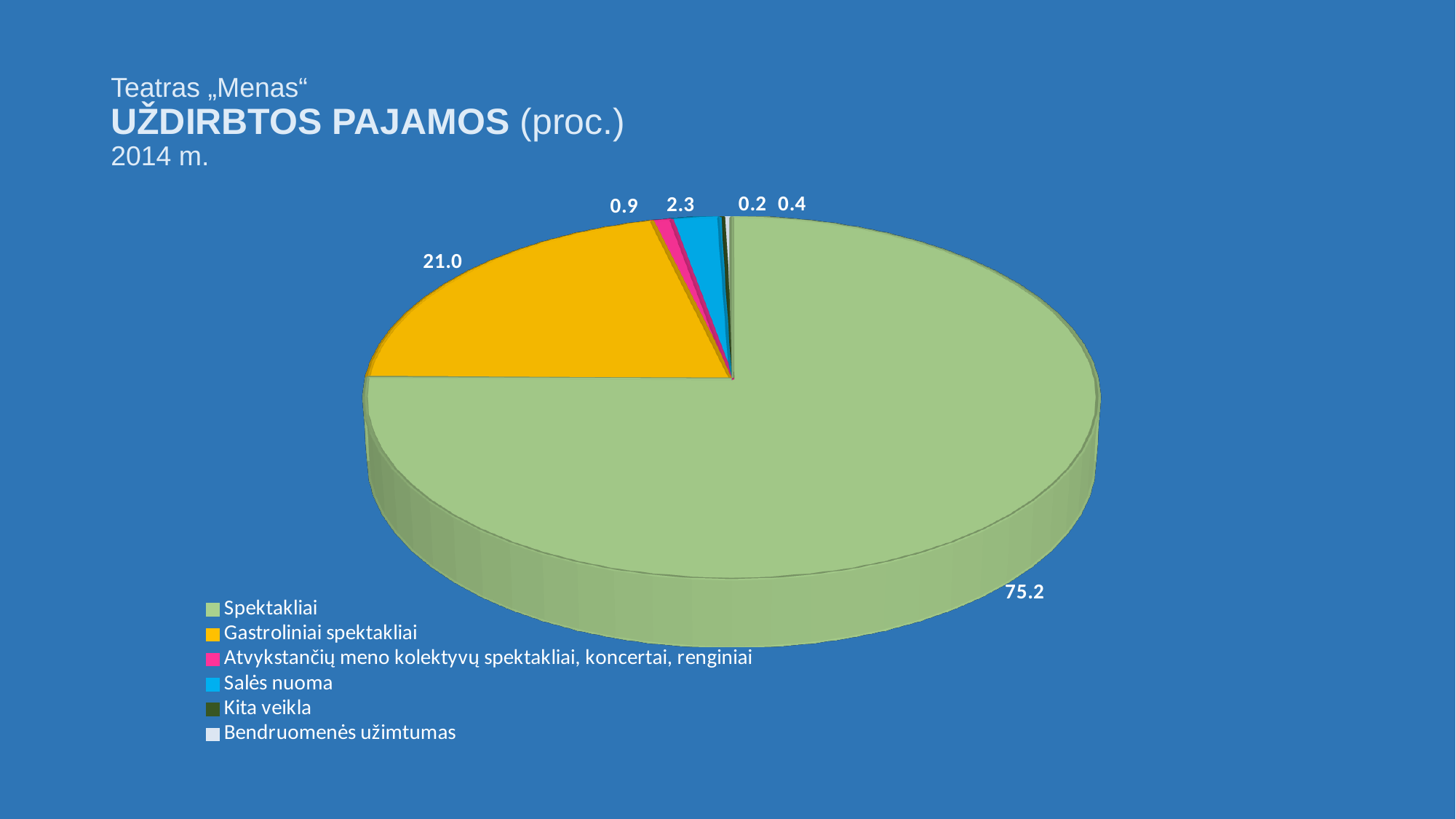
Which category has the largest share of the pie? Spektakliai Which category has the smallest share of the pie? Kita veikla Which is larger, the value for Salės nuoma or the value for Atvykstančių meno kolektyvų spektakliai, koncertai, renginiai? Salės nuoma What is the value for Bendruomenės užimtumas? 0.4 What kind of chart is shown on the slide? pie chart What is the value for Gastroliniai spektakliai? 21.0 What is the difference between the values for Spektakliai and Gastroliniai spektakliai? 54.2 What is the value for Spektakliai? 75.2 What is the value for Kita veikla? 0.2 How many categories does the legend list? 6 What is the value for Atvykstančių meno kolektyvų spektakliai, koncertai, renginiai? 0.9 What is the value for Salės nuoma? 2.3